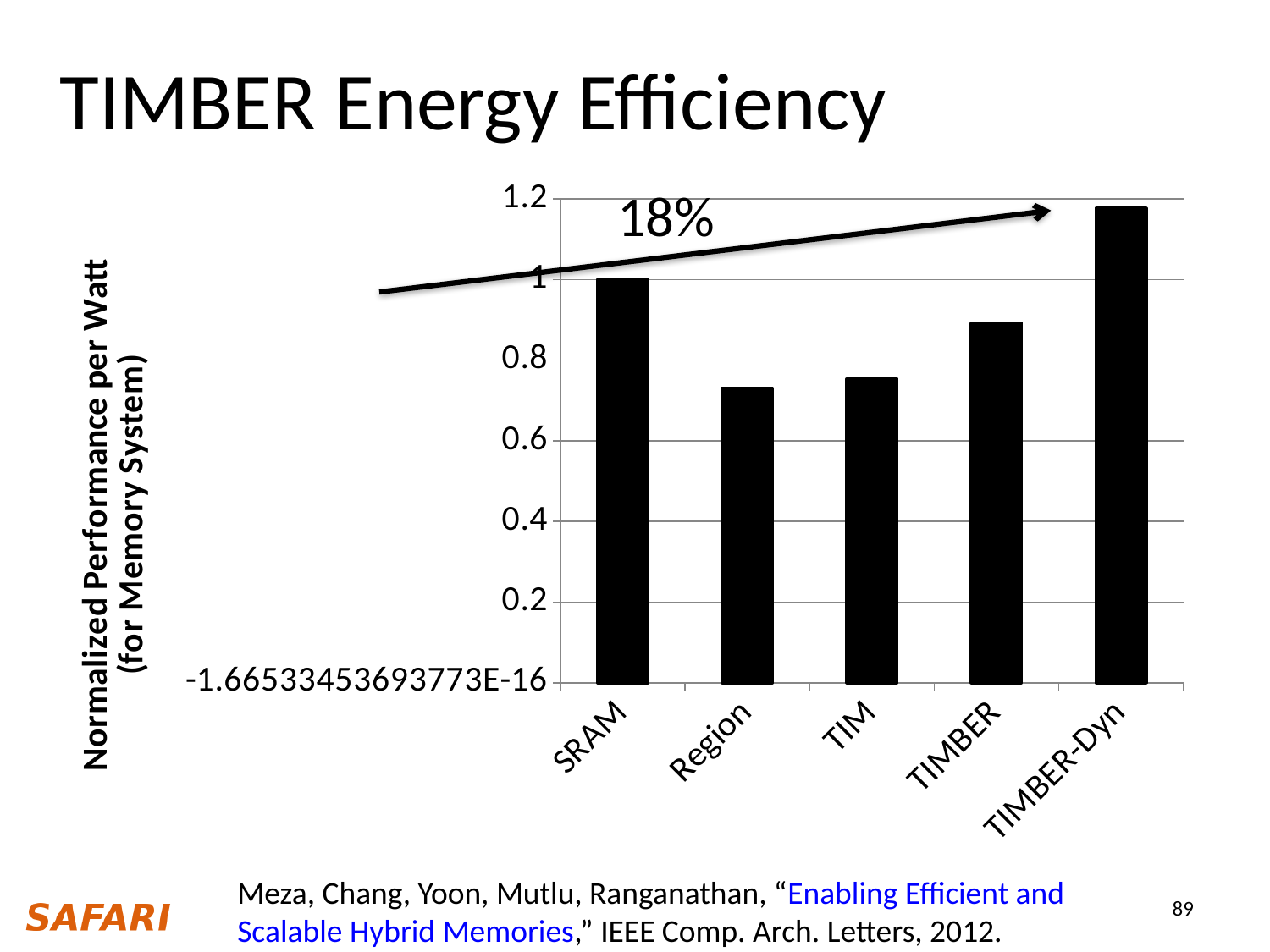
Is the value for TIMBER greater or less than 0.8? greater Is the value for TIMBER-Dyn greater or less than 1? greater What percentage is written next to the arrow annotation on the chart? 18% Is the value for Region greater or less than 0.8? less What kind of chart is shown on the slide? bar chart What is the label of the y axis? Normalized Performance per Watt (for Memory System) Which category has the highest normalized performance per watt? TIMBER-Dyn Which has a larger value, SRAM or TIM? SRAM How many categories are plotted on the x axis? 5 Which has a larger value, TIMBER or Region? TIMBER What is the normalized performance per watt for SRAM? 1